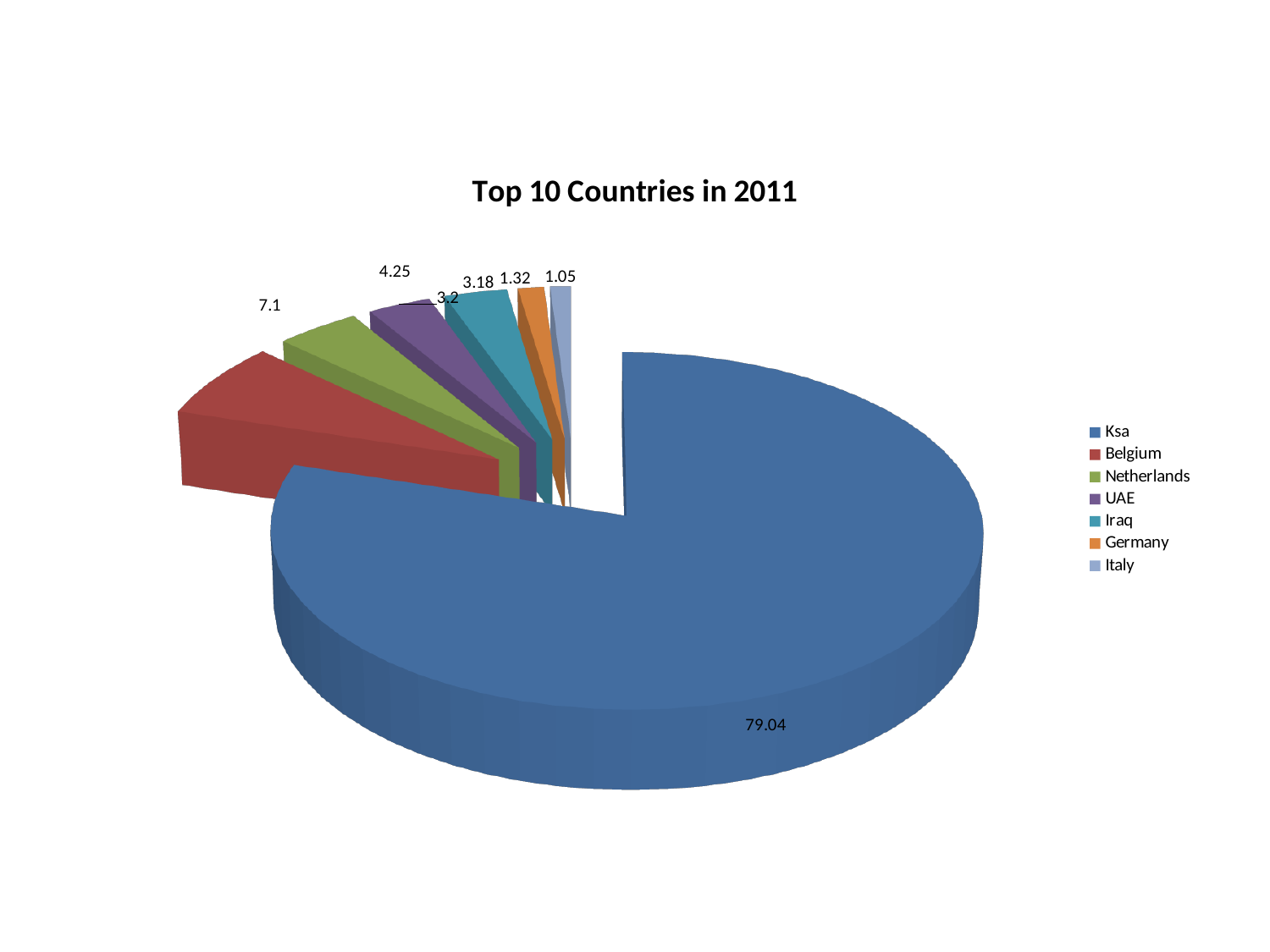
Which country has the smallest slice of the pie? Italy What kind of chart is shown on the slide? Pie chart What is the value shown for Netherlands? 4.25 How many countries are listed in the legend? 7 Which is larger, the value for Belgium or the value for Germany? Belgium Which country has the largest slice of the pie? Ksa What is the difference between the values for Belgium and Netherlands? 2.85 What is the title of the chart? Top 10 Countries in 2011 What is the value shown for Germany? 1.32 What is the value shown for Belgium? 7.1 What is the value shown for Ksa? 79.04 What is the value shown for Italy? 1.05